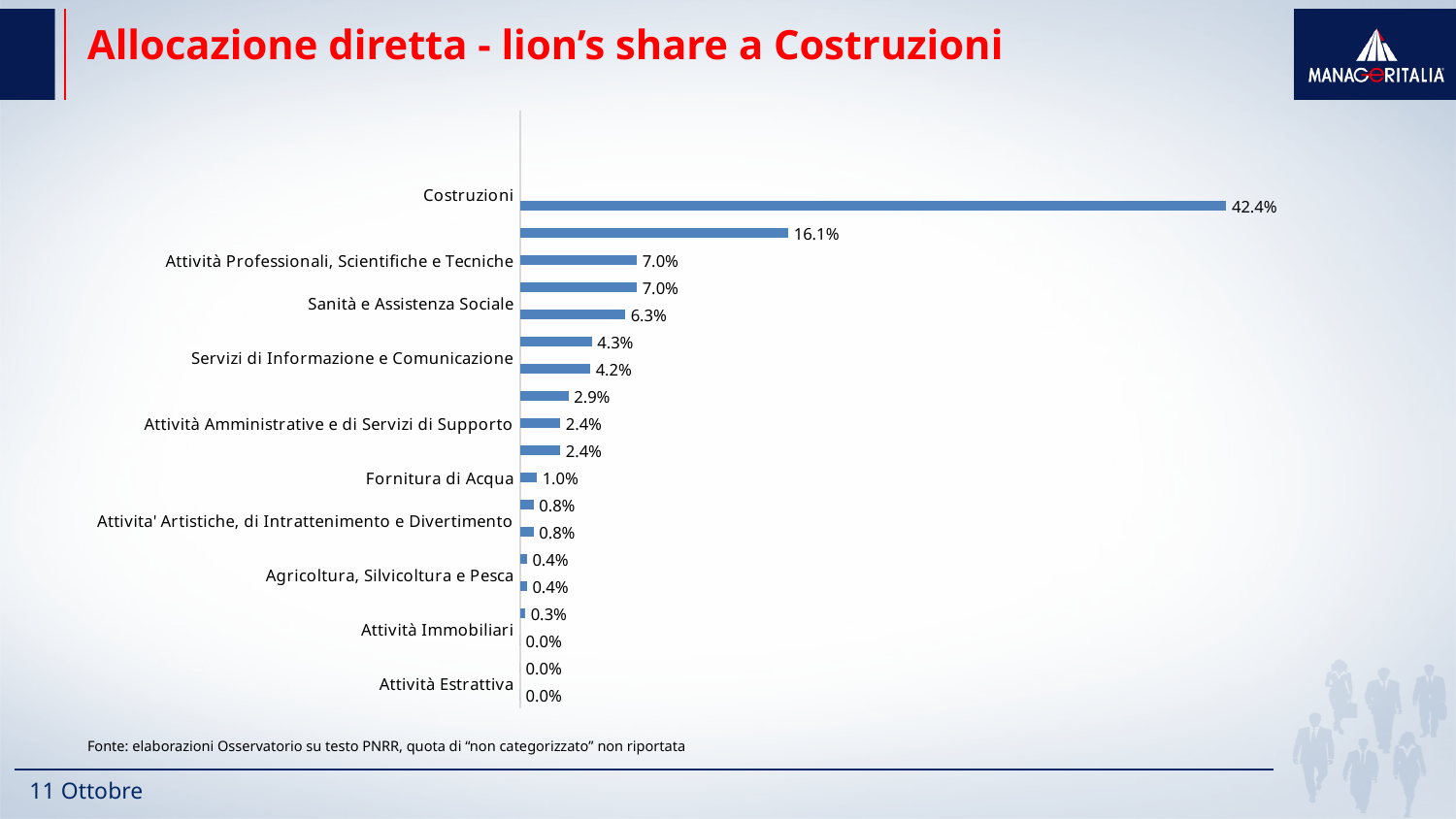
What is the value for Sanità e Assistenza Sociale? 6.3% What is the difference between the values for Sanità e Assistenza Sociale and Fornitura di Acqua? 5.3% What is the difference between the values for Costruzioni and Attività Professionali, Scientifiche e Tecniche? 35.4% What is the value for Attività Estrattiva? 0.0% What is the value for Agricoltura, Silvicoltura e Pesca? 0.4% What is the value of the second-longest bar? 16.1% What is the value for Fornitura di Acqua? 1.0% What kind of chart is shown on the slide? Bar chart What is the title of the slide? Allocazione diretta - lion's share a Costruzioni What is the value for Costruzioni? 42.4% Which is larger, the value for Sanità e Assistenza Sociale or the value for Servizi di Informazione e Comunicazione? Sanità e Assistenza Sociale Which category has the highest value? Costruzioni